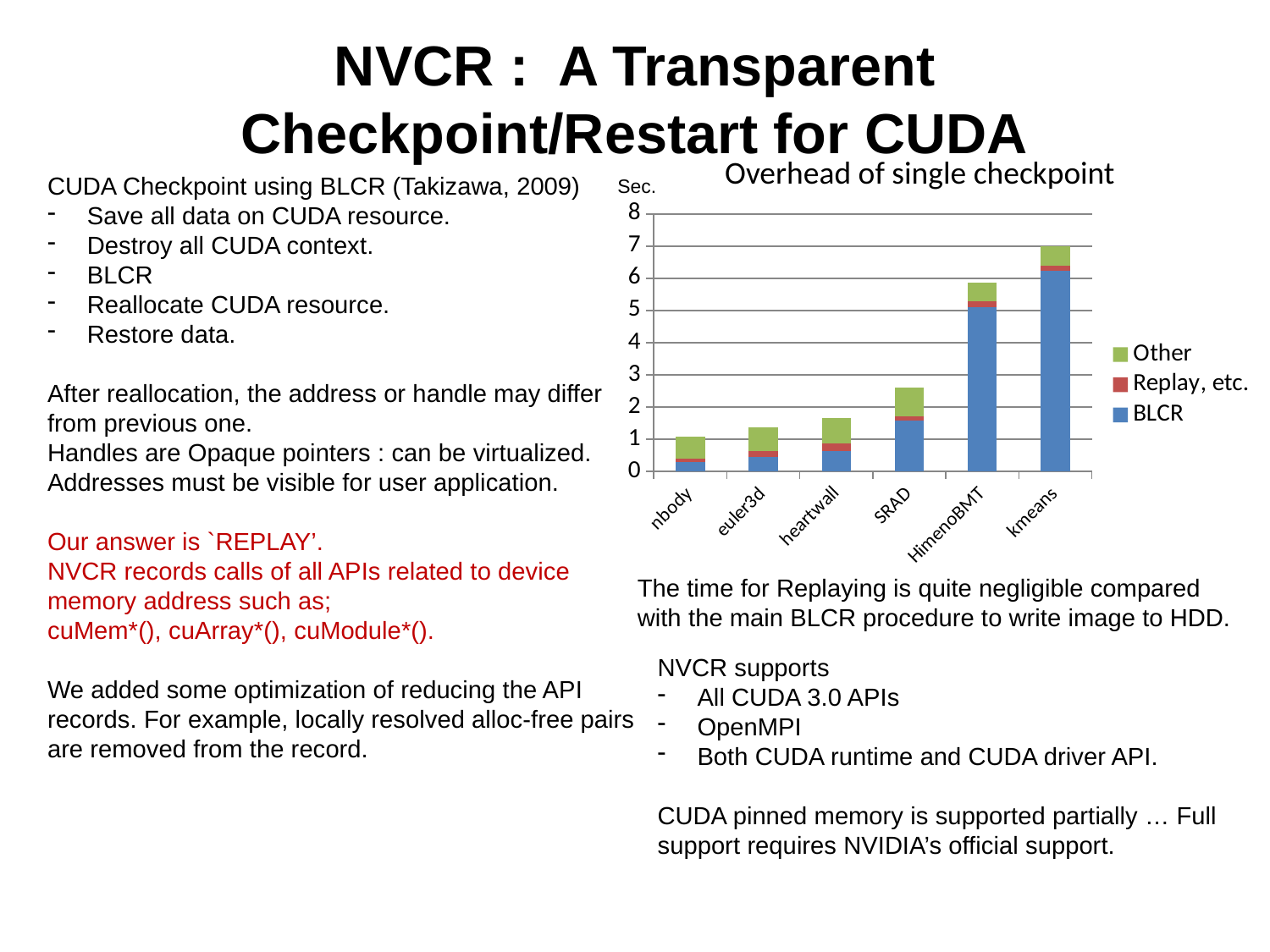
Which benchmark has the highest total checkpoint overhead? kmeans Is the total overhead for HimenoBMT greater or less than 4 seconds? greater Do the total overhead values rise or fall moving from nbody to kmeans along the x axis? rise Which has the larger total overhead, SRAD or heartwall? SRAD Which benchmark has the lowest total checkpoint overhead? nbody Is the total overhead for nbody greater or less than 2 seconds? less Is the total overhead for SRAD greater or less than 2 seconds? greater What is the title of the chart? Overhead of single checkpoint How many series does the chart legend list? 3 How many benchmark categories are shown on the x axis of the chart? 6 What kind of chart is shown on the slide? stacked bar chart